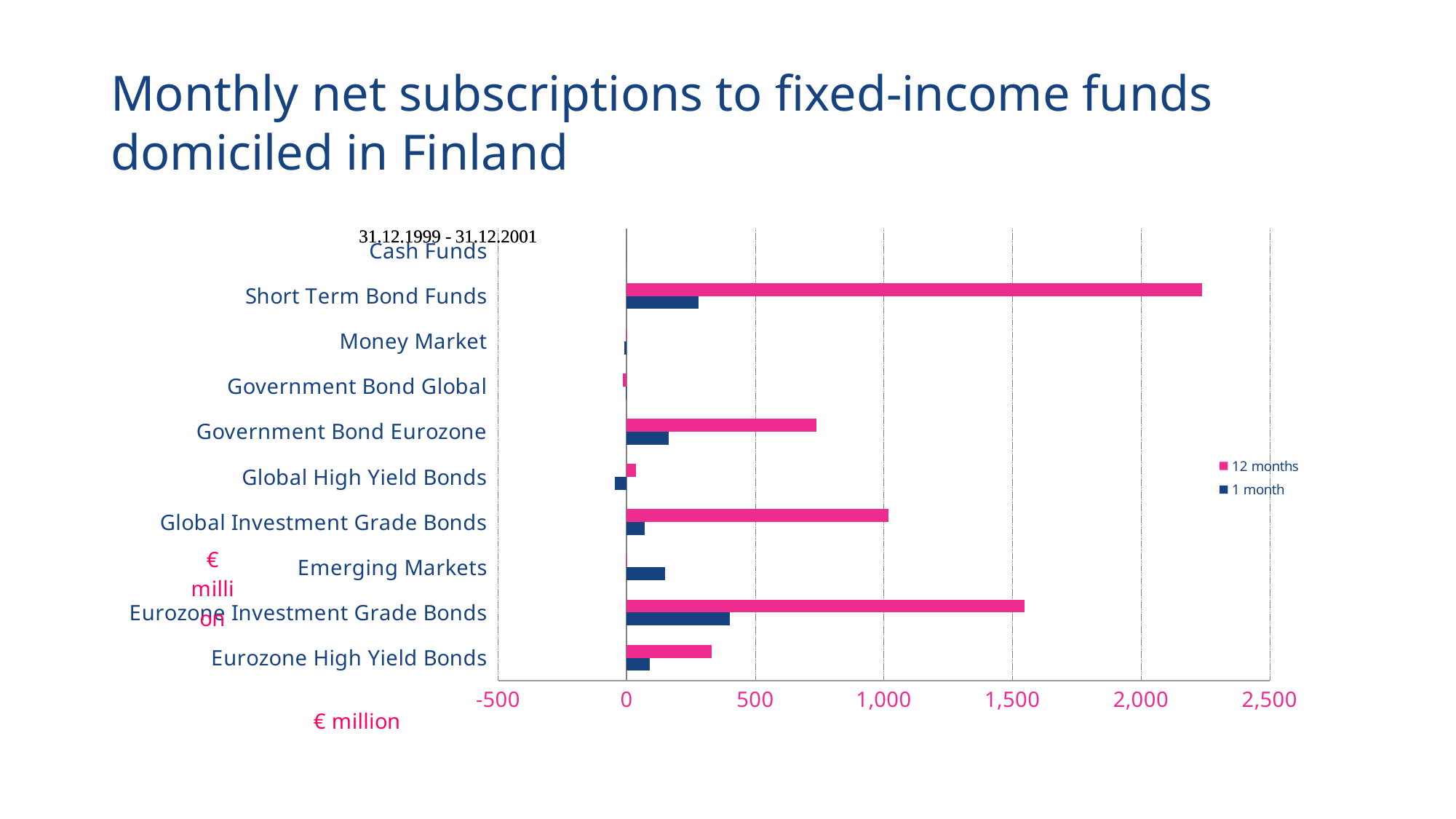
What unit is shown on the horizontal axis label? € million For the 1 month series, which is larger: Emerging Markets or Global Investment Grade Bonds? Emerging Markets Which category has the highest 1 month value? Eurozone Investment Grade Bonds Is the 12 months value for Eurozone Investment Grade Bonds greater or less than 1,000? greater What kind of chart is shown on the slide? bar chart How many fund categories are listed on the vertical axis? 10 Is the 12 months value for Government Bond Eurozone greater or less than 1,000? less Is the 12 months value for Short Term Bond Funds greater or less than 2,000? greater For the 12 months series, which is larger: Global Investment Grade Bonds or Government Bond Eurozone? Global Investment Grade Bonds How many series does the legend list? 2 Which category has the highest 12 months value? Short Term Bond Funds Which category has the lowest 1 month value? Global High Yield Bonds